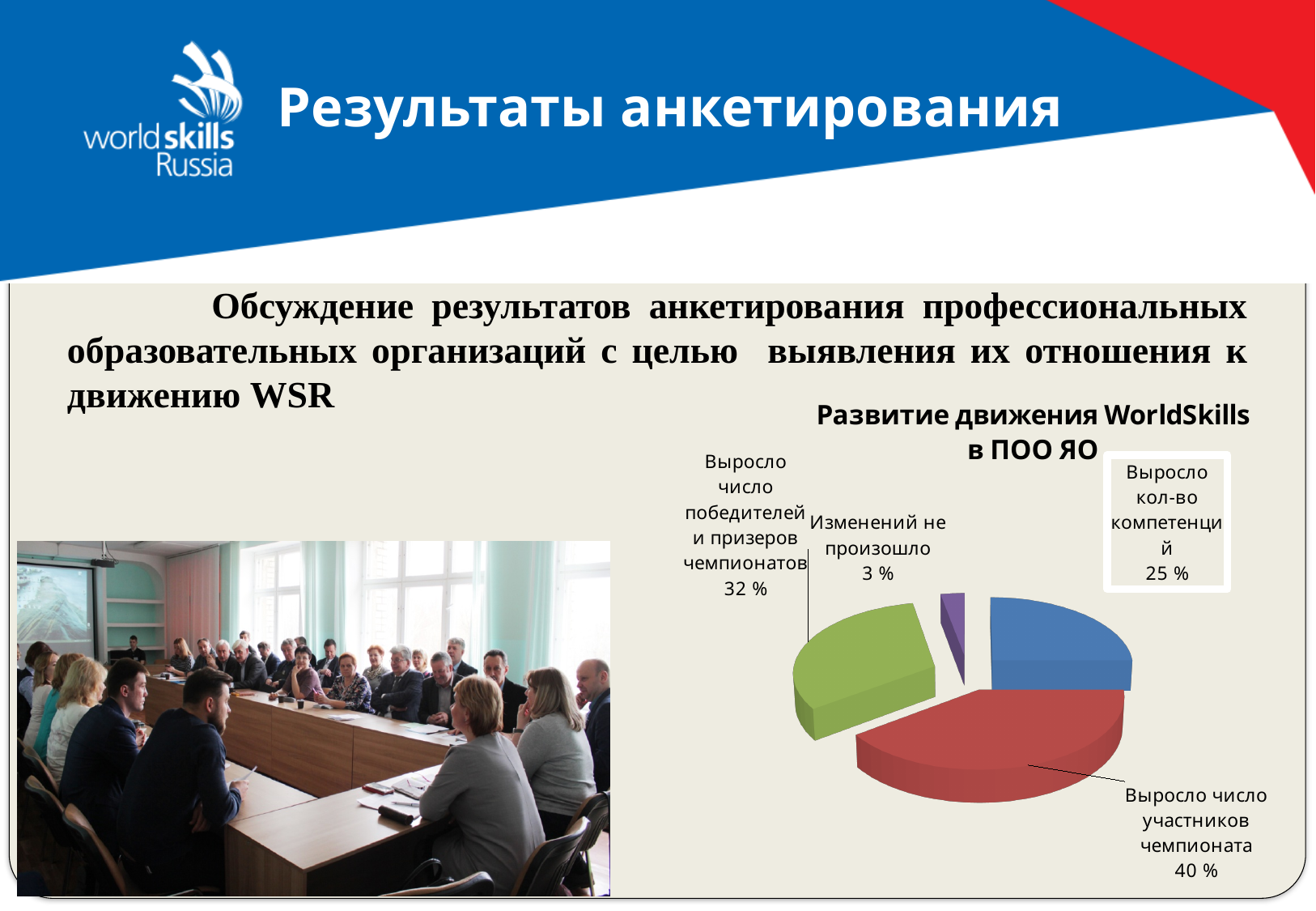
What share of the pie is labelled "Изменений не произошло"? 3 % What colour is the slice for "Выросло число участников чемпионата"? Red Which is larger: the share for "Выросло число победителей и призеров чемпионатов" or the share for "Выросло кол-во компетенций"? Выросло число победителей и призеров чемпионатов What share of the pie is labelled "Выросло кол-во компетенций"? 25 % What is the title of the chart? Развитие движения WorldSkills в ПОО ЯО Which slice of the pie chart is the largest? Выросло число участников чемпионата What kind of chart is shown on the slide? Pie chart Which slice of the pie chart is the smallest? Изменений не произошло What share of the pie is labelled "Выросло число участников чемпионата"? 40 % What share of the pie is labelled "Выросло число победителей и призеров чемпионатов"? 32 % How many slices does the pie chart have? 4 What is the difference in percentage points between "Выросло число участников чемпионата" and "Выросло кол-во компетенций"? 15